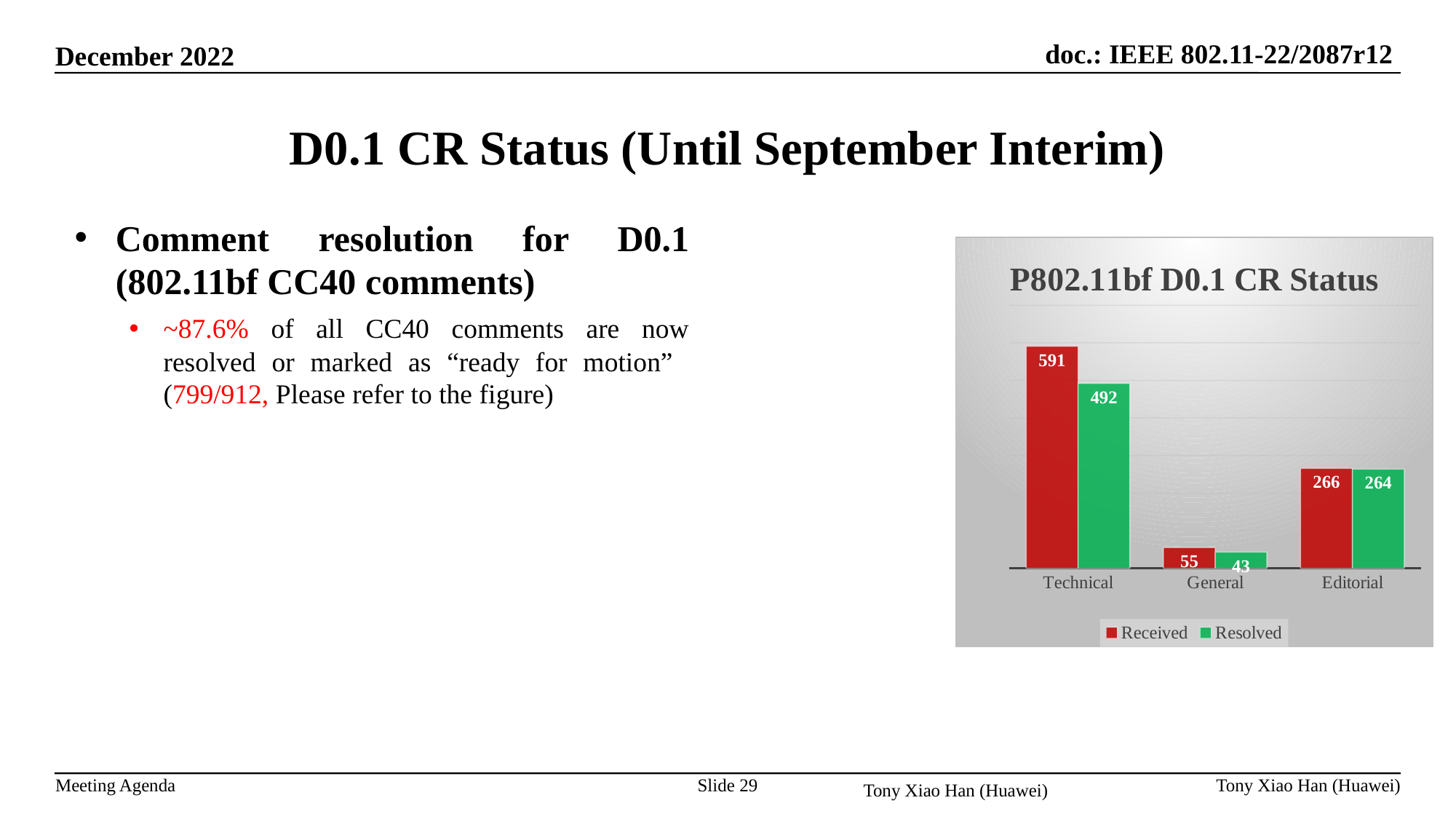
Which category has the highest number of Received comments? Technical What is the Resolved value for Technical comments? 492 Which category has the lowest number of Resolved comments? General What is the Received value for Technical comments? 591 What is the title of the chart? P802.11bf D0.1 CR Status What is the Received value for General comments? 55 How many categories are shown on the x axis? 3 Which is larger, the Received value for Editorial or the Received value for General? Editorial How many series does the legend list? 2 What is the Resolved value for Editorial comments? 264 What is the difference between Received and Resolved comments for General? 12 What is the difference between Received and Resolved comments for Technical? 99